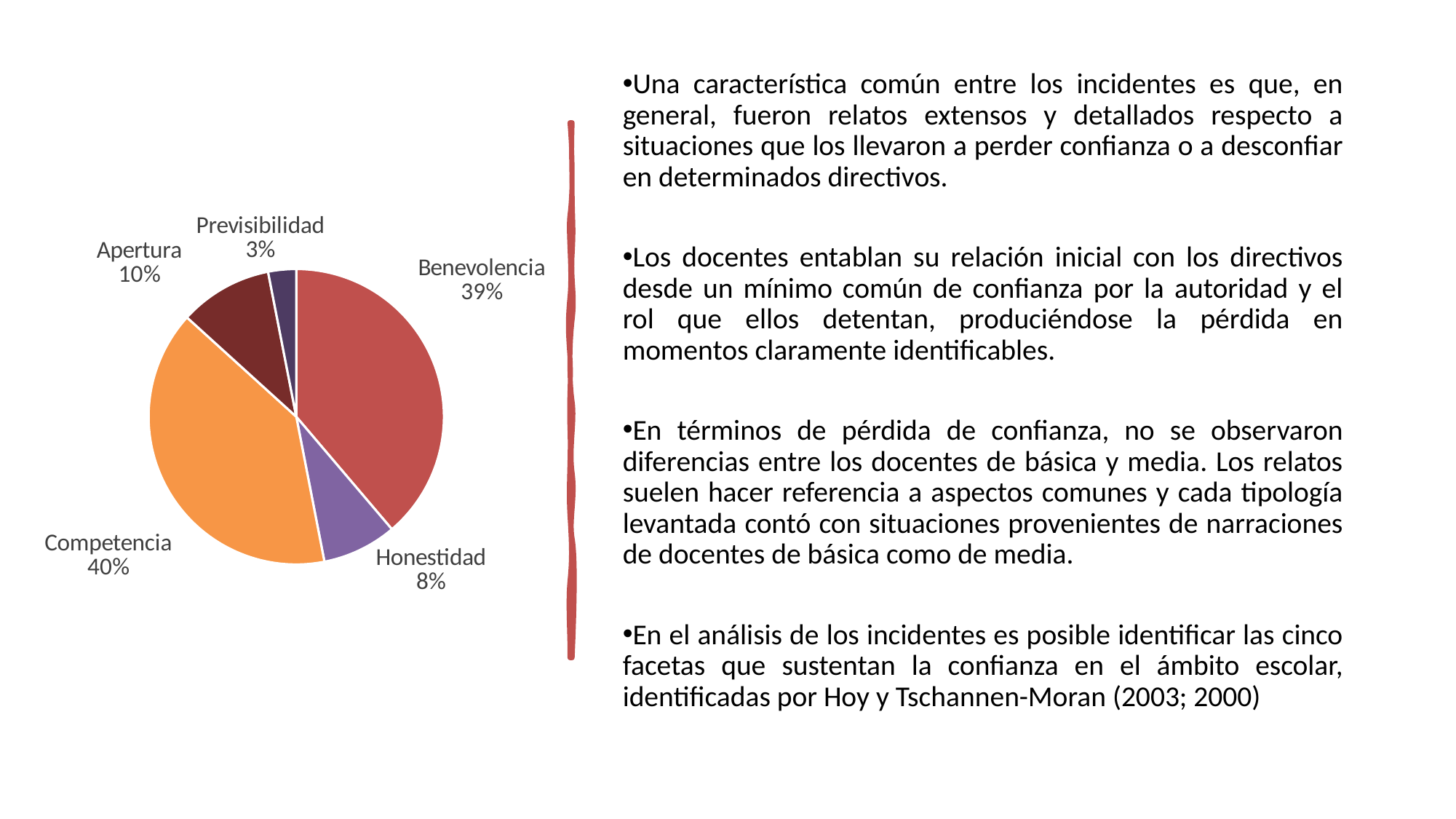
Which is larger, the slice for Apertura or the slice for Honestidad? Apertura Which category has the smallest slice of the pie? Previsibilidad How many slices does the pie chart have? 5 What is the value shown for Competencia? 40% Which category has the largest slice of the pie? Competencia What share of the pie does Benevolencia represent? 39% What is the value shown for Honestidad? 8% What kind of chart is shown on the slide? pie chart What is the combined share of Competencia and Benevolencia? 79% What is the value shown for Apertura? 10% What is the difference in percentage points between Benevolencia and Apertura? 29 What is the difference in percentage points between Competencia and Honestidad? 32